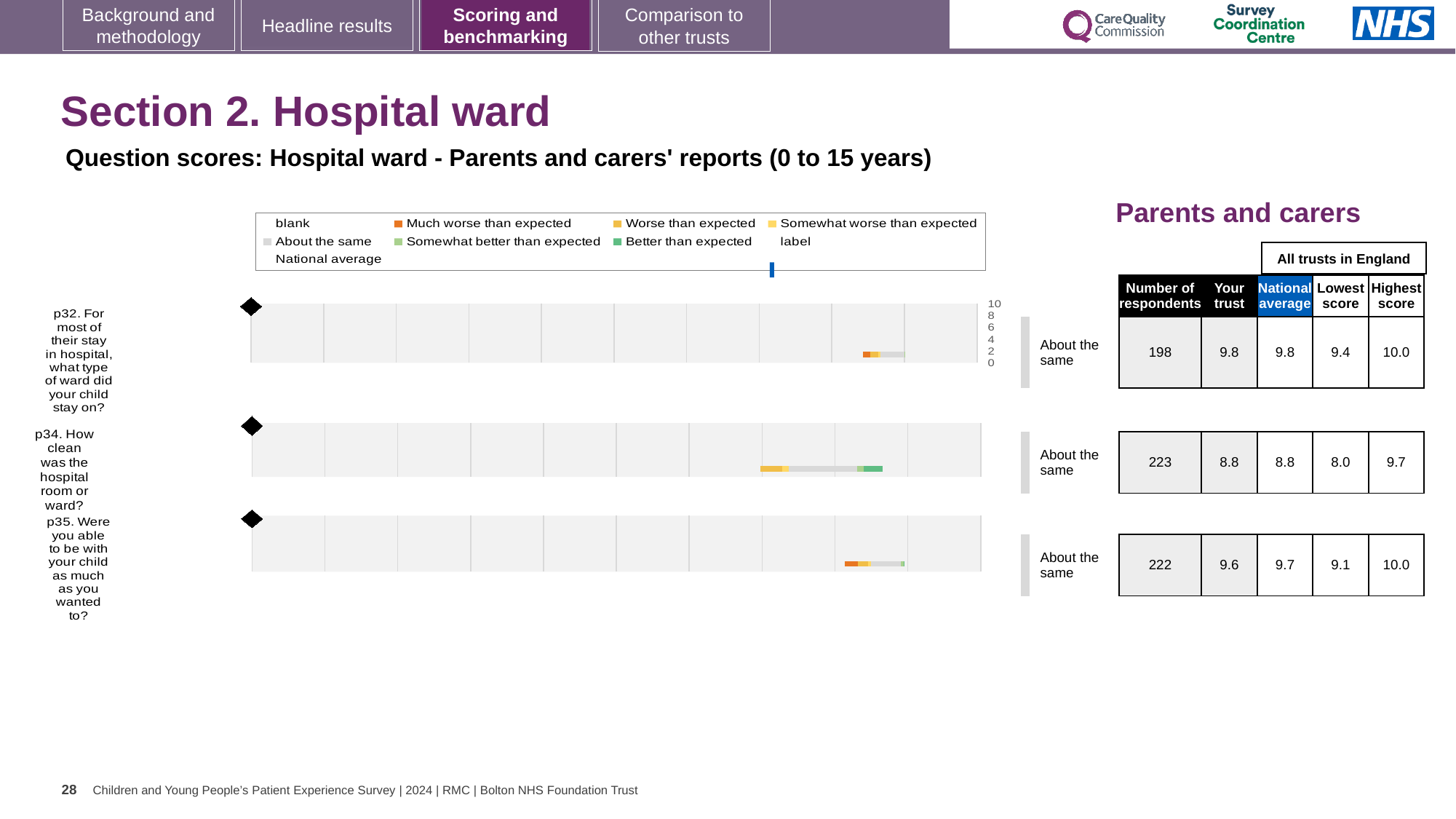
Which of the three questions has the lowest 'Your trust' score in the table beside the chart? p34. How clean was the hospital room or ward? In the table beside the chart, what is the 'Lowest score' for p34 'How clean was the hospital room or ward?' 8.0 Which of the three questions has the highest 'Your trust' score in the table beside the chart? p32. For most of their stay in hospital, what type of ward did your child stay on? What kind of chart is shown on the slide? bar chart What colour does the legend use for 'Much worse than expected'? orange In the table beside the chart, how many respondents are listed for p34 'How clean was the hospital room or ward?' 223 In the table beside the chart, what is the 'Highest score' for p35 'Were you able to be with your child as much as you wanted to?' 10.0 Is the 'Your trust' score higher for p32 or for p34 in the table beside the chart? p32 How many survey questions (categories) are plotted in the chart? 3 What benchmark label is shown next to the bar for p34 'How clean was the hospital room or ward?' About the same What is the difference between the 'National average' and the 'Your trust' score for p35 in the table beside the chart? 0.1 In the table beside the chart, what is the 'Your trust' score for p32 'For most of their stay in hospital, what type of ward did your child stay on?' 9.8